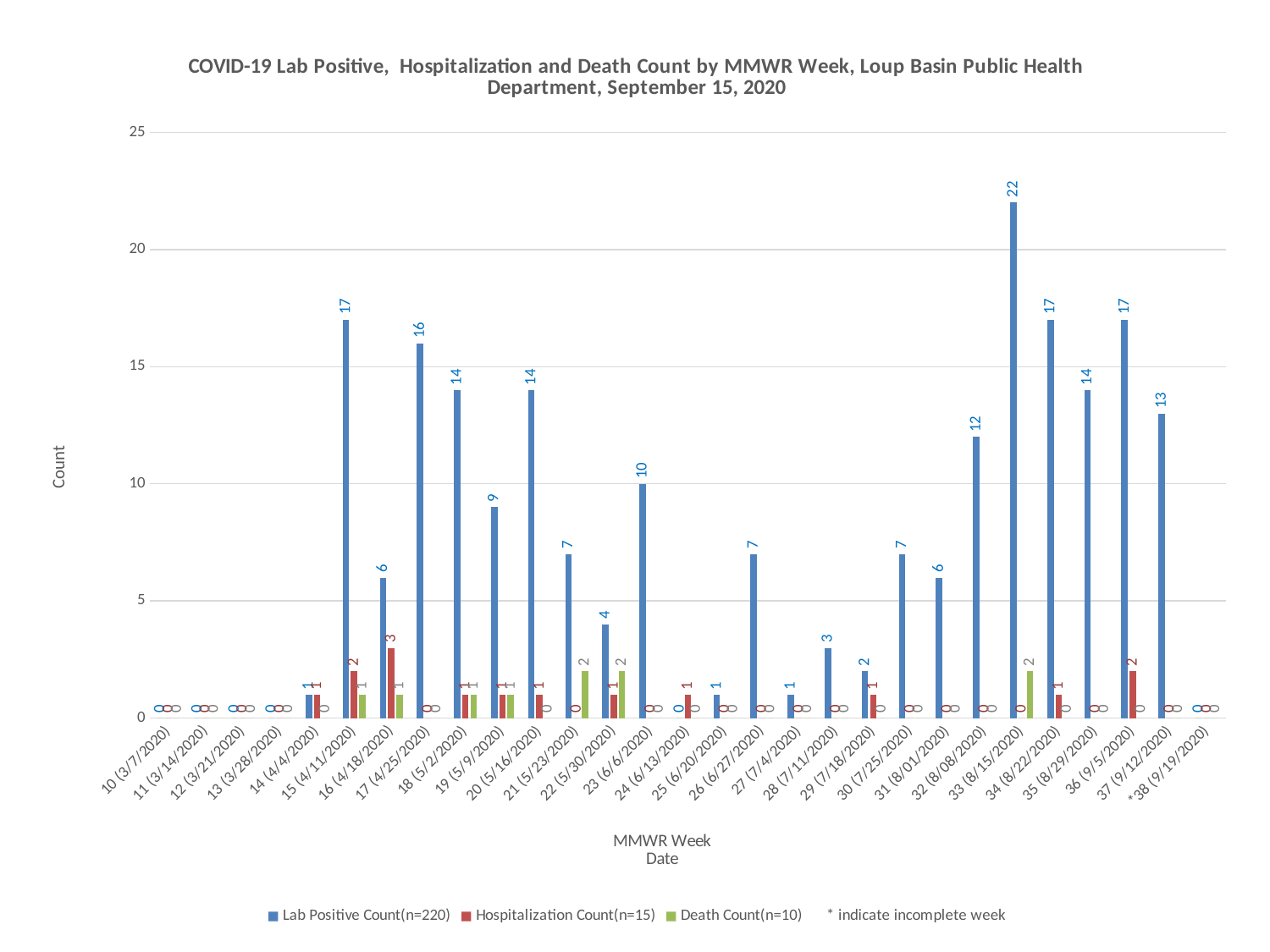
How many series does the legend list? 3 What is the difference between the Lab Positive Count for week 33 (8/15/2020) and week 34 (8/22/2020)? 5 Which MMWR week has the highest Lab Positive Count? 33 (8/15/2020) What does the asterisk on week 38 indicate, according to the legend note? Incomplete week What kind of chart is shown on the slide? Bar chart Does the Lab Positive Count rise or fall from week 32 (8/08/2020) to week 33 (8/15/2020)? Rise Which MMWR week has the highest Hospitalization Count? 16 (4/18/2020) How many MMWR weeks are shown on the x axis? 29 Which is larger, the Lab Positive Count for week 15 (4/11/2020) or for week 17 (4/25/2020)? Week 15 (4/11/2020) What is the Hospitalization Count for MMWR week 16 (4/18/2020)? 3 What is the Lab Positive Count for MMWR week 33 (8/15/2020)? 22 What is the Death Count for MMWR week 21 (5/23/2020)? 2